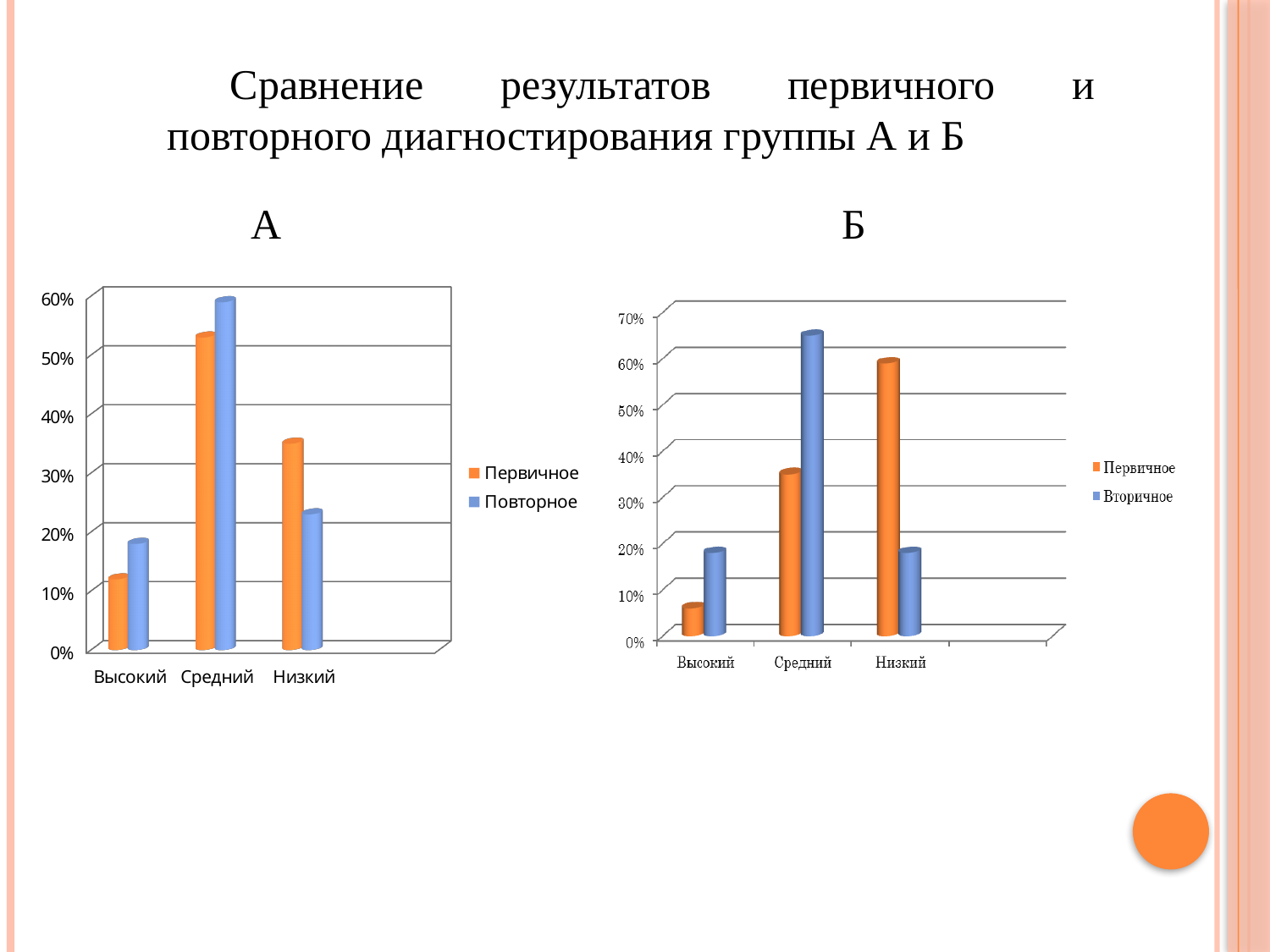
In chart А, for Низкий, which is larger: Первичное or Повторное? Первичное In chart Б, which category has the highest Вторичное value? Средний In chart А, is the Повторное value for Средний greater or less than 50%? greater In chart А, which category has the highest Первичное value? Средний In chart А, is the Первичное value for Высокий greater or less than 20%? less What are the two legend entries of chart Б? Первичное and Вторичное What kind of chart is chart А? bar chart How many categories are shown on the x axis of chart А? 3 How many series does the legend of chart Б list? 2 In chart Б, which category has the lowest Первичное value? Высокий In chart А, which category has the lowest Повторное value? Высокий In chart Б, is the Вторичное value for Средний greater or less than 60%? greater